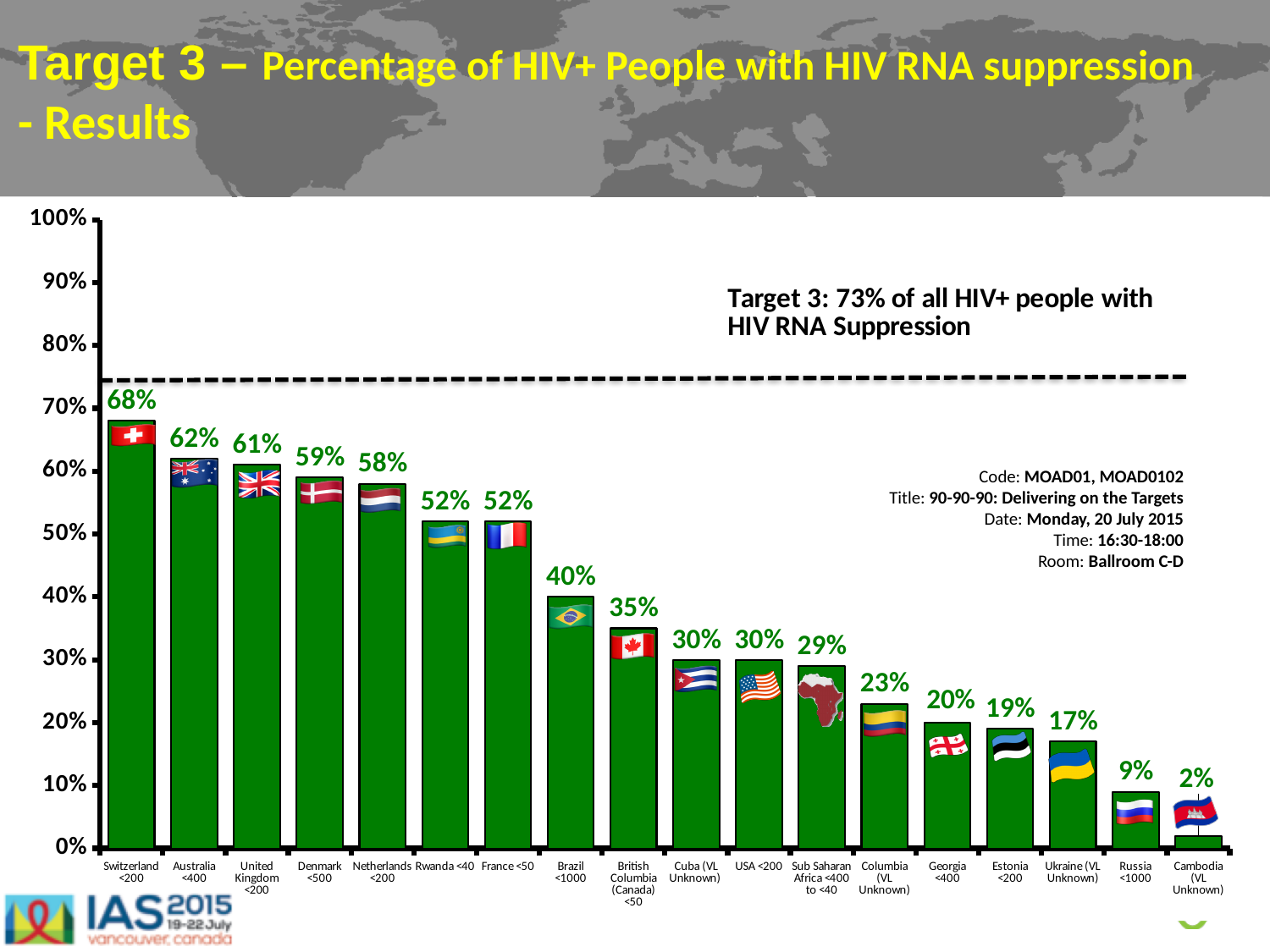
What kind of chart is shown on the slide? Bar chart How many countries or regions are shown in the chart? 18 What target percentage does the dashed horizontal line represent? 73% What is the value for Brazil? 40% What is the value for Ukraine (VL Unknown)? 17% What is the value for Switzerland? 68% What is the difference between the values for Australia and Russia? 53% What is the value for Georgia? 20% Which country has the lowest percentage of HIV+ people with HIV RNA suppression? Cambodia Do the values rise or fall from left to right along the x axis? Fall Which country has the highest percentage of HIV+ people with HIV RNA suppression? Switzerland Which has a larger value, Denmark or British Columbia (Canada)? Denmark